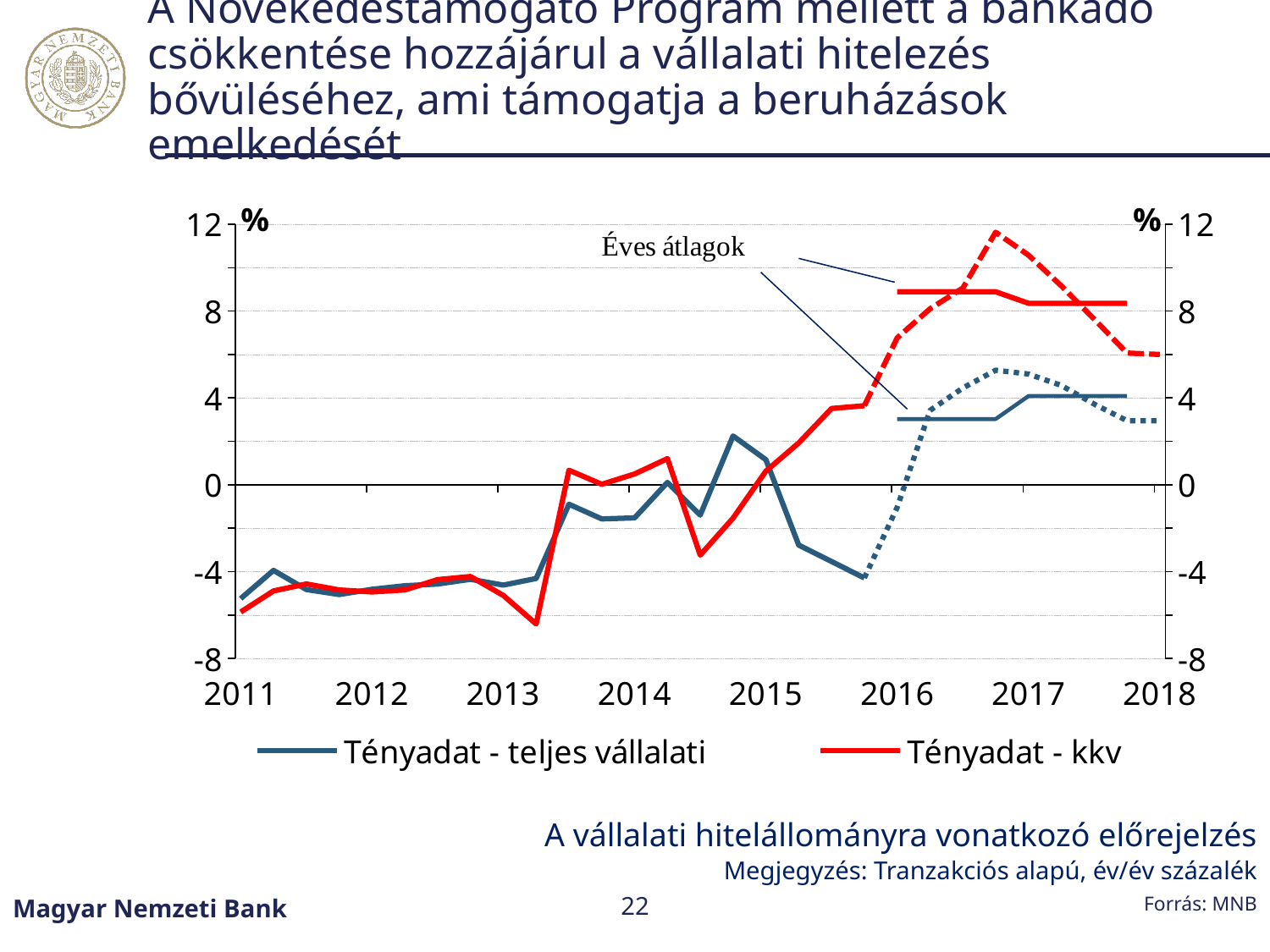
Is the value of 'Tényadat - teljes vállalati' at the end of the chart (2018) greater or less than 4? less Is the value of 'Tényadat - teljes vállalati' at the start of 2011 greater or less than -4? less How many year labels are shown on the x axis? 8 Is the value of 'Tényadat - kkv' at the end of the chart (2018) greater or less than 4? greater At the end of the chart (2018), which series has the higher value, 'Tényadat - kkv' or 'Tényadat - teljes vállalati'? Tényadat - kkv How many series does the legend list? 2 What is the highest value shown on the y axis? 12 What colour is the line for 'Tényadat - kkv'? red Overall, does the 'Tényadat - kkv' line rise or fall from 2011 to 2018? rise What are the two series named in the legend? Tényadat - teljes vállalati; Tényadat - kkv What kind of chart is shown on the slide? line chart